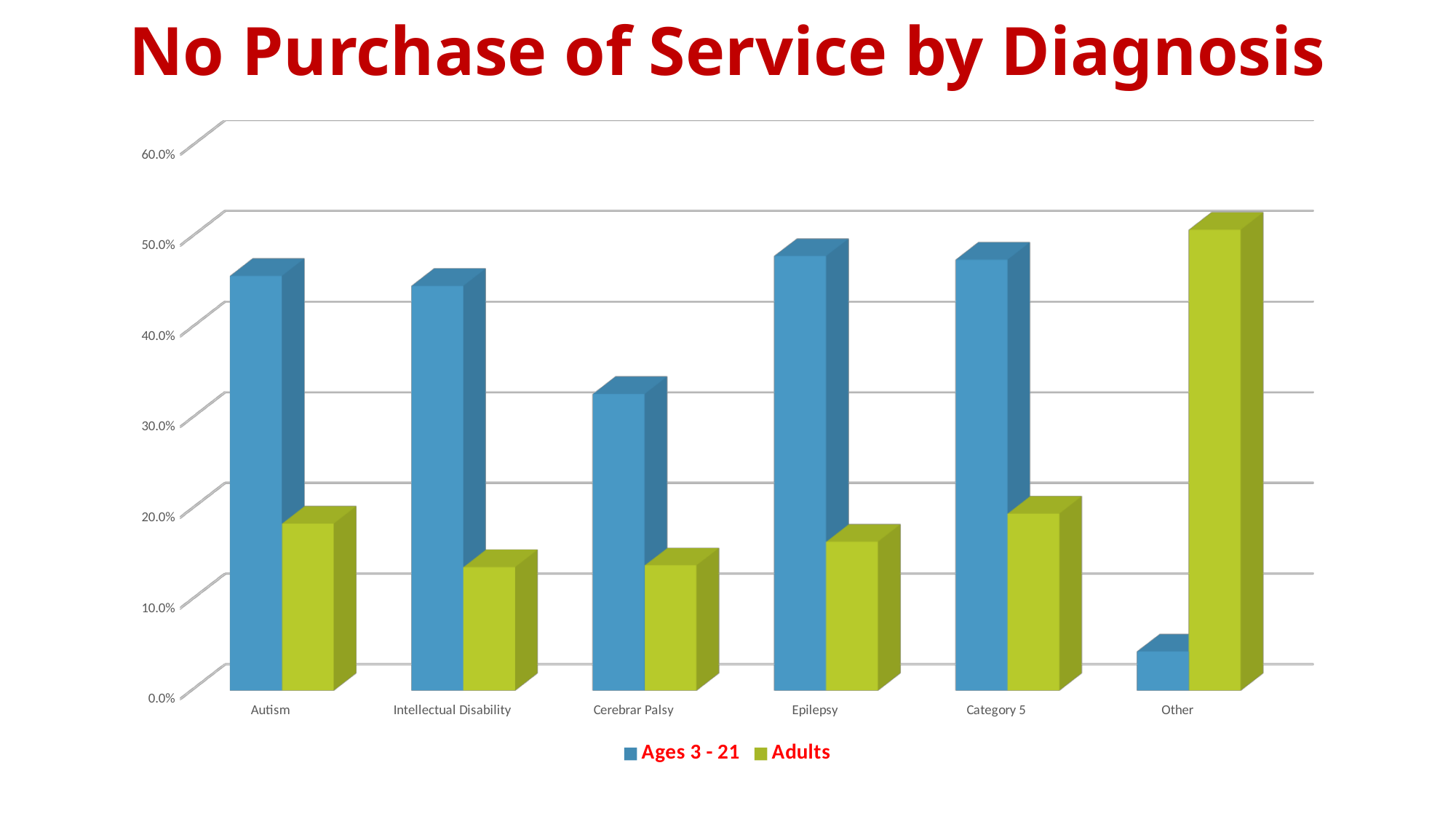
What kind of chart is shown on the slide? Bar chart Which category has the highest value for the Adults series? Other Which category has the lowest value for the Ages 3 - 21 series? Other What is the title of the chart? No Purchase of Service by Diagnosis For Autism, which series has the larger value, Ages 3 - 21 or Adults? Ages 3 - 21 How many diagnosis categories are shown on the x axis? 6 Is the Ages 3 - 21 value for Other greater or less than 10.0%? less Which series is shown in green in the legend? Adults How many series does the legend list? 2 Is the Adults value for Other greater or less than 40.0%? greater Is the Ages 3 - 21 value for Cerebrar Palsy greater or less than 40.0%? less For Other, which series has the larger value, Ages 3 - 21 or Adults? Adults